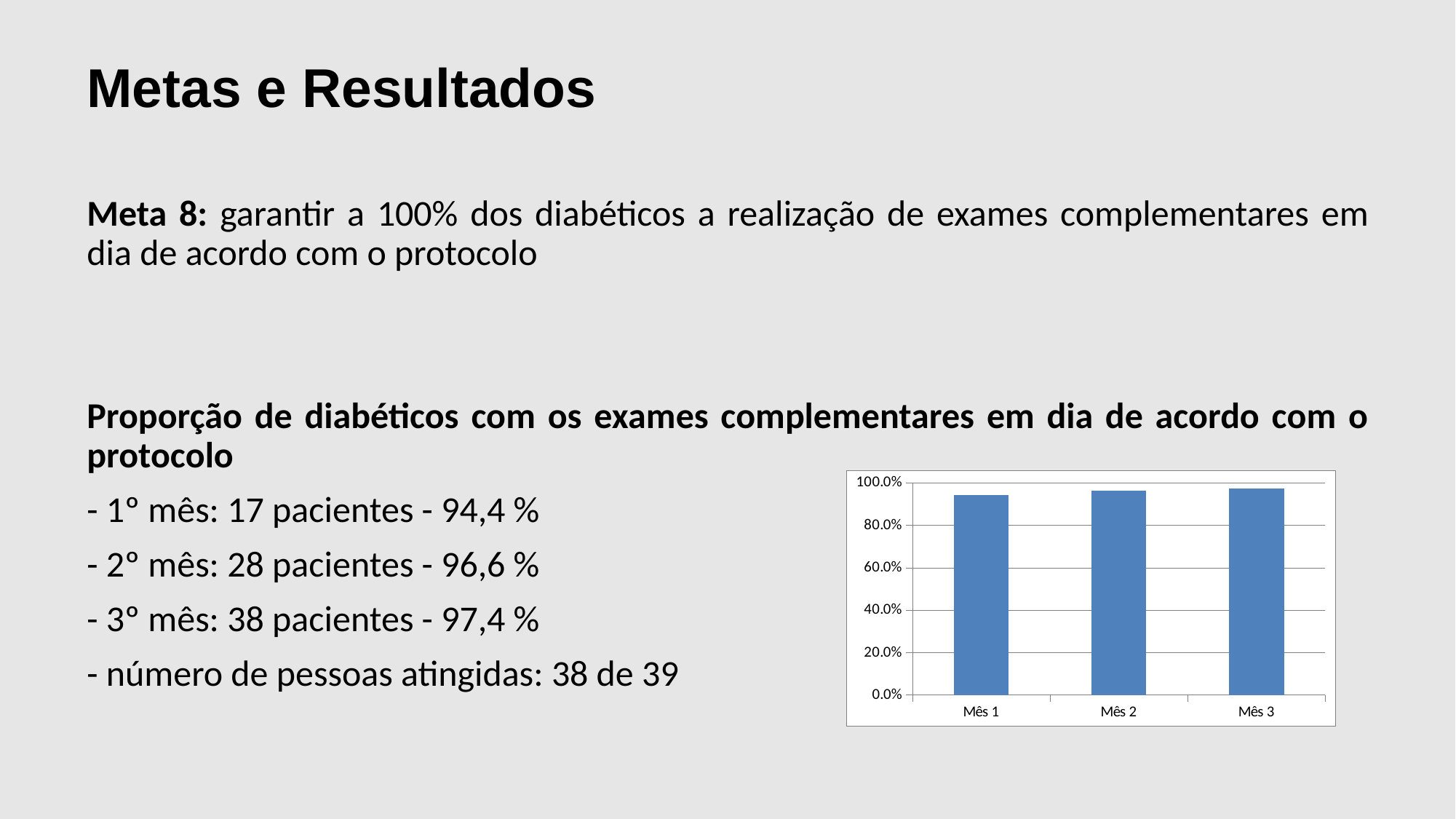
Which is larger, the value for Mês 1 or the value for Mês 3? Mês 3 How many categories are plotted on the x axis of the chart? 3 Is the value for Mês 3 greater or less than 100.0%? less What is the label of the first category on the x axis of the chart? Mês 1 What is the highest tick value shown on the y axis of the chart? 100.0% Is the value for Mês 1 greater or less than 80.0%? greater Is the value for Mês 2 greater or less than 60.0%? greater What kind of chart is shown on the slide? bar chart Do the bar values rise or fall from Mês 1 to Mês 3? rise Which category has the shortest bar in the chart? Mês 1 Which category has the tallest bar in the chart? Mês 3